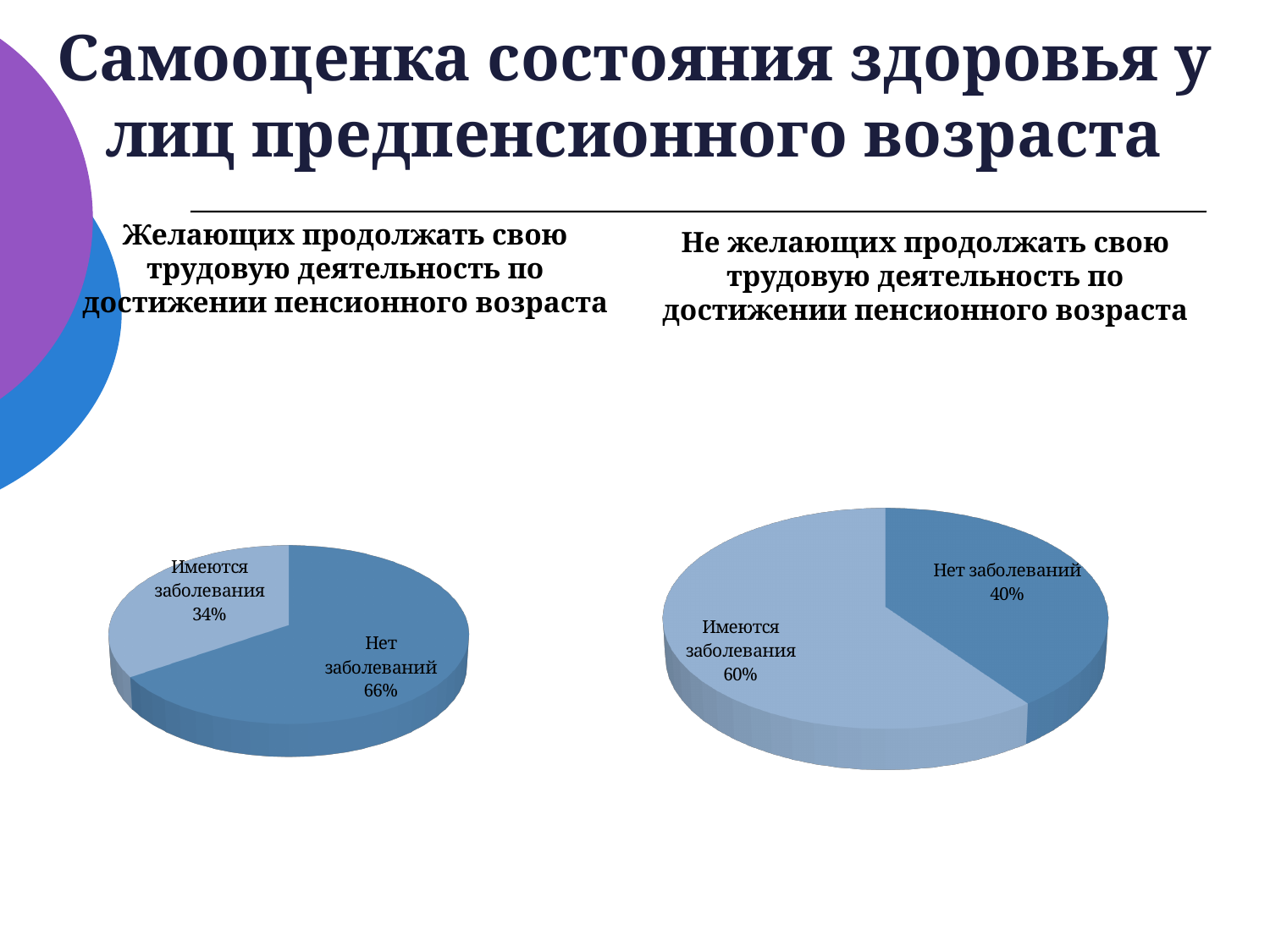
In the left pie chart (those wishing to continue working after reaching retirement age), what share is labelled 'Нет заболеваний'? 66% What type of chart is used on the left side of the slide? Pie chart How many slices does the right pie chart have? 2 In the left pie chart (those wishing to continue working), what share is labelled 'Имеются заболевания'? 34% In the right pie chart, which slice is the smallest? Нет заболеваний In the right pie chart (those not wishing to continue working after reaching retirement age), what share is labelled 'Имеются заболевания'? 60% How many pie charts are shown on the slide? 2 In the right pie chart, what is the difference between the 'Имеются заболевания' and 'Нет заболеваний' shares? 20% In the left pie chart, which slice is the largest? Нет заболеваний In the left pie chart, what is the difference between the 'Нет заболеваний' and 'Имеются заболевания' shares? 32% Which is larger: the 'Имеются заболевания' share in the left pie chart or in the right pie chart? Right pie chart